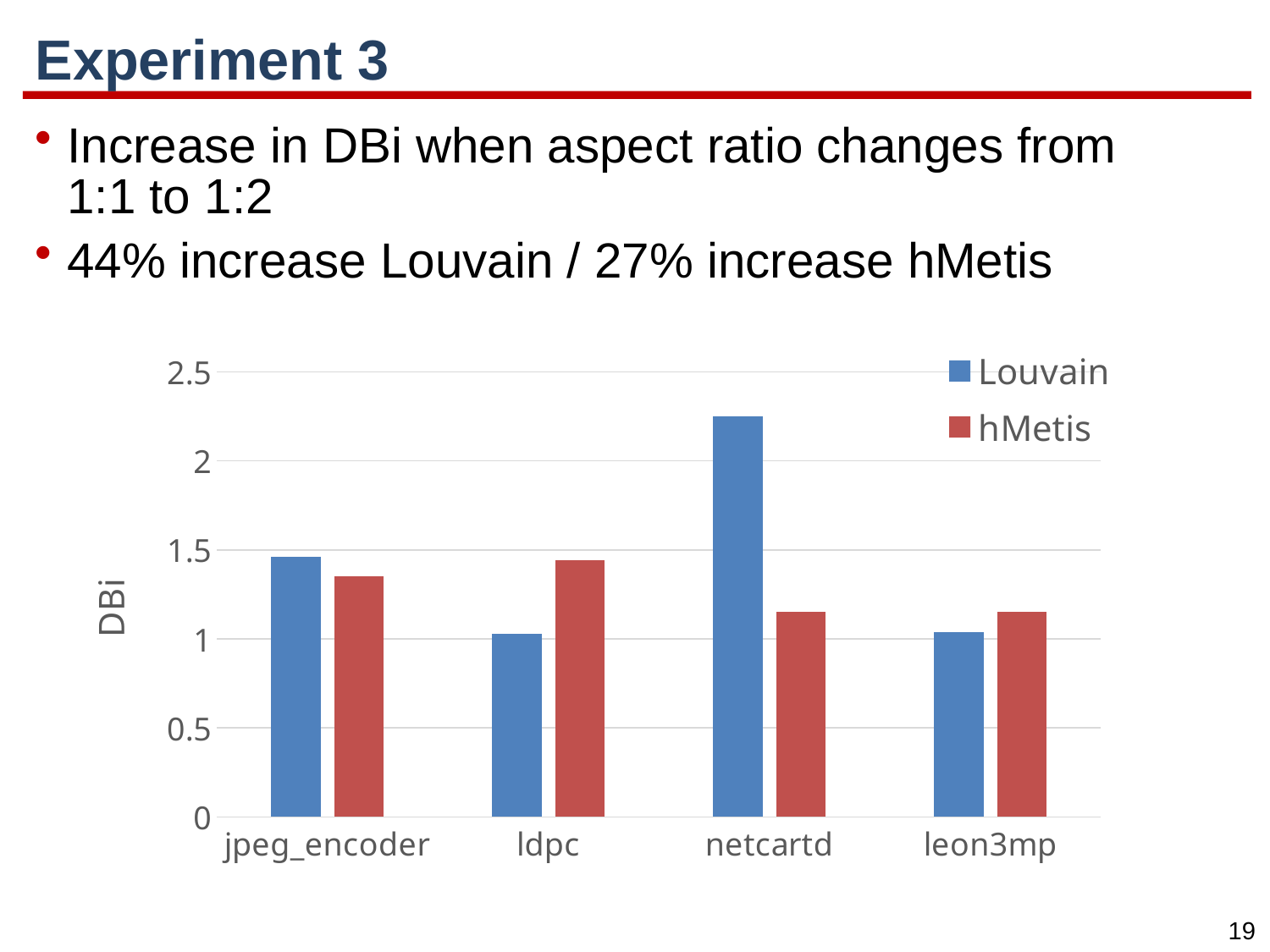
Which colour represents the hMetis series in the chart? red How many categories are shown on the x axis of the chart? 4 What is the label on the y axis of the chart? DBi For ldpc, which is larger: the Louvain value or the hMetis value? hMetis Which category has the highest Louvain value? netcartd For jpeg_encoder, which is larger: the Louvain value or the hMetis value? Louvain Is the Louvain value for netcartd greater or less than 2? greater For netcartd, which is larger: the Louvain value or the hMetis value? Louvain What kind of chart is shown on the slide? bar chart Which category has the highest hMetis value? ldpc How many series does the chart's legend list? 2 Is the hMetis value for ldpc greater or less than 1.5? less